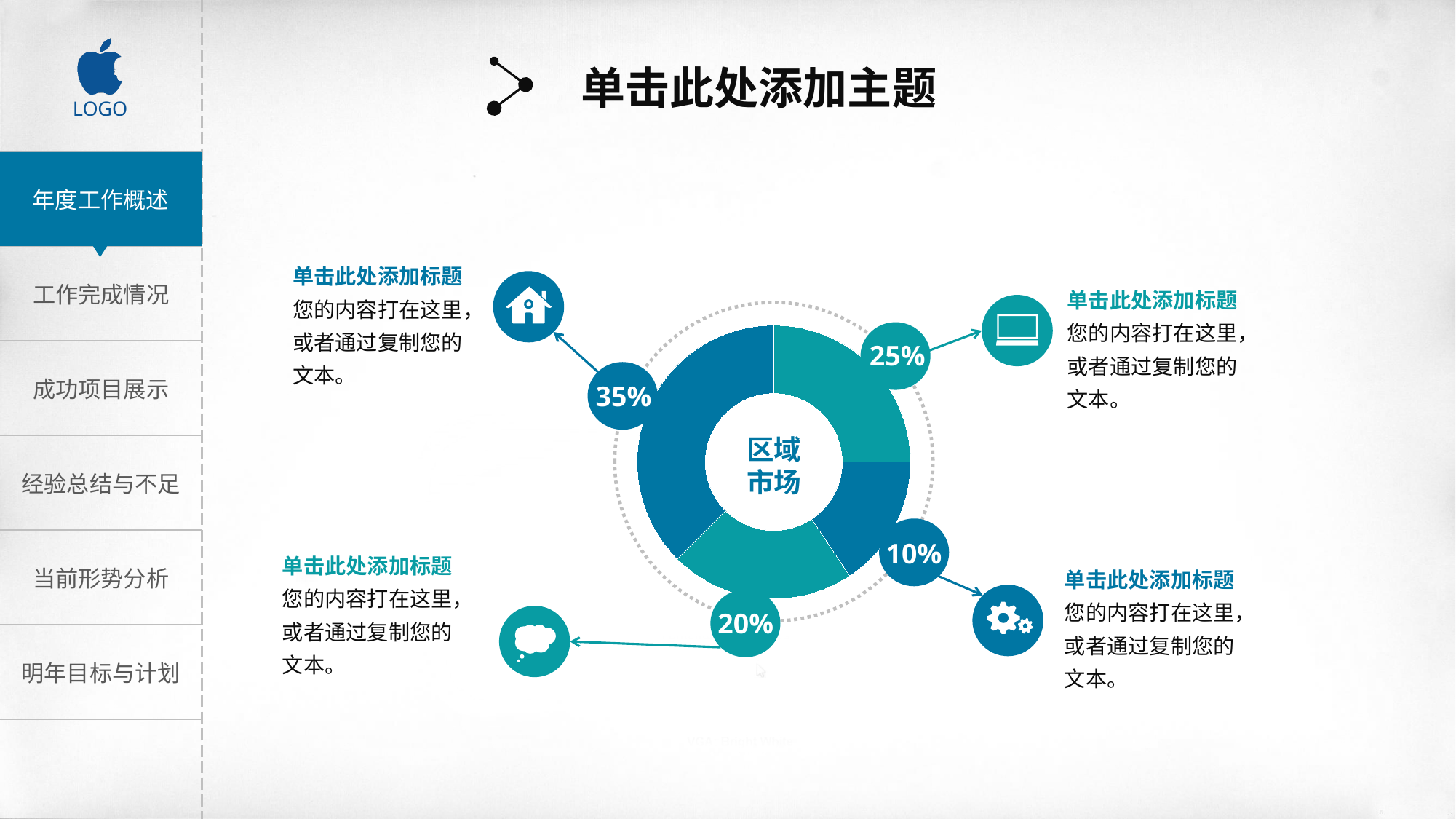
What is the difference between the largest labelled value (35%) and the smallest labelled value (10%)? 25% What is the smallest percentage value labelled on the chart? 10% What is the difference between the 25% label and the 20% label? 5% What text is printed in the centre of the donut chart? 区域市场 How many percentage labels are shown around the donut chart? 4 What is the difference between the 35% label and the 20% label? 15% What kind of chart is shown on the slide? pie chart (donut) Which icon is connected to the 35% label? house icon What is the largest percentage value labelled on the chart? 35% Which is larger, the 25% label or the 20% label? 25%